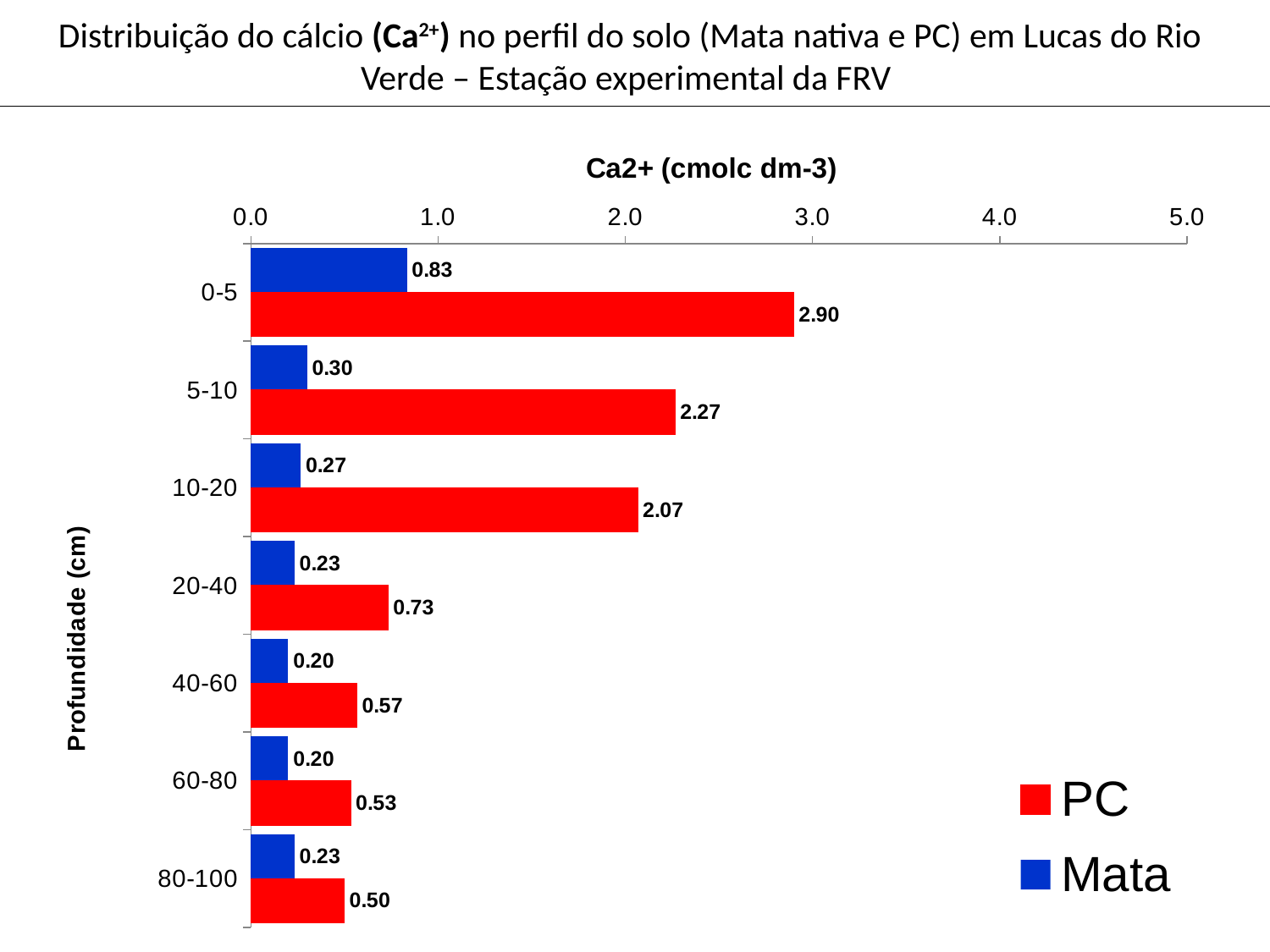
How many series does the legend list? 2 What is the PC value for the 20-40 cm depth? 0.73 How many depth categories are shown on the chart? 7 Which is larger at the 10-20 cm depth, PC or Mata? PC What is the PC value for the 0-5 cm depth? 2.90 Which colour represents the Mata series? Blue Which depth has the lowest PC value? 80-100 Which depth has the highest Mata value? 0-5 Which depth has the highest PC value? 0-5 What is the Mata value for the 5-10 cm depth? 0.30 What is the difference between the PC and Mata values at the 0-5 cm depth? 2.07 What kind of chart is shown on the slide? Bar chart